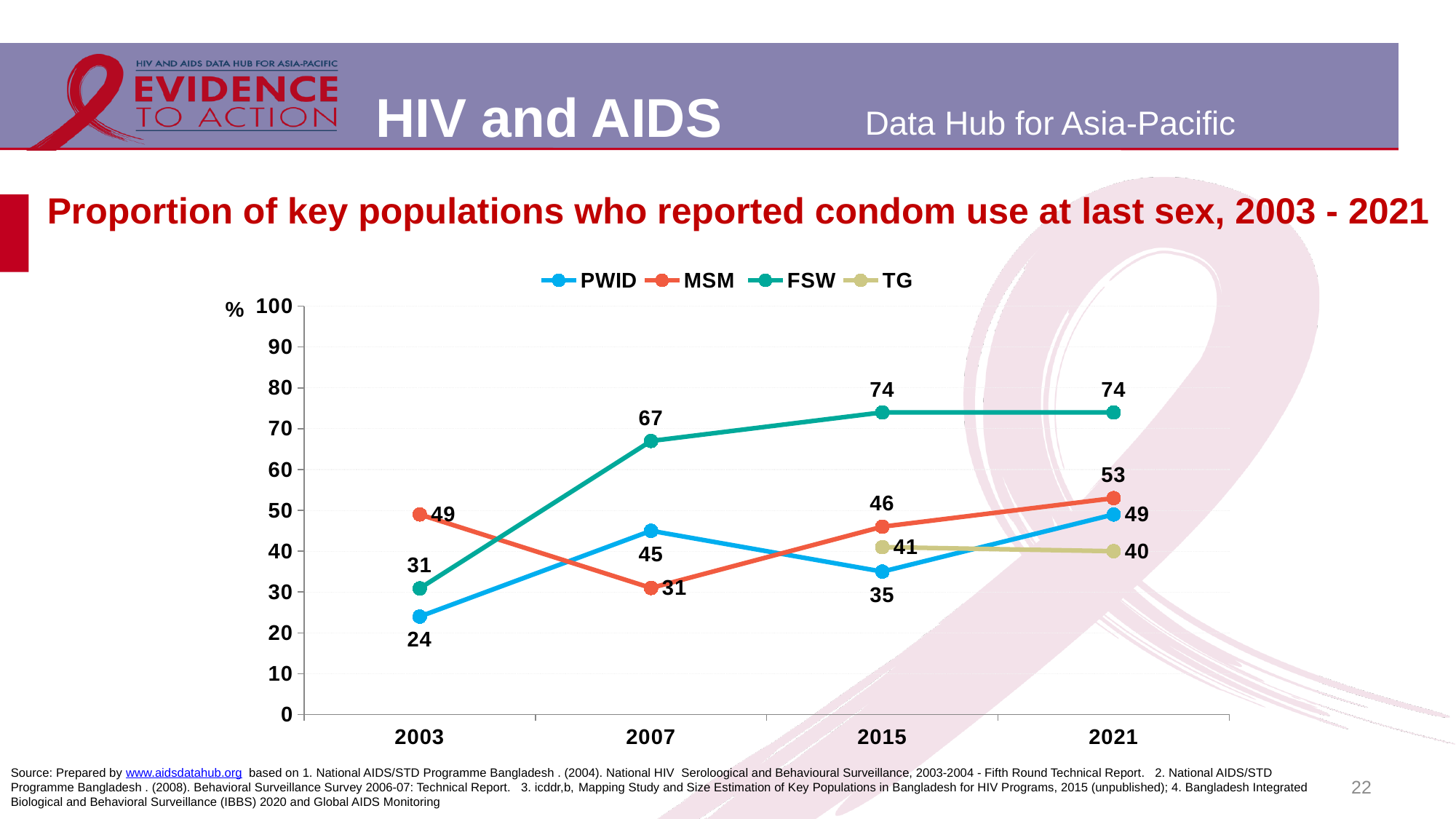
What was the value for MSM in 2015? 46 What was the value for TG in 2021? 40 What was the value for PWID in 2003? 24 What type of chart is shown on the slide? line chart What was the value for FSW in 2007? 67 Did the value for FSW rise or fall between 2003 and 2015? rise Which key population had the lowest value in 2007? MSM How many years are shown on the x axis? 4 In 2003, which was larger, the value for MSM or the value for FSW? MSM How many series does the legend list? 4 What is the difference between the FSW value and the PWID value in 2015? 39 Which key population had the highest value in 2021? FSW